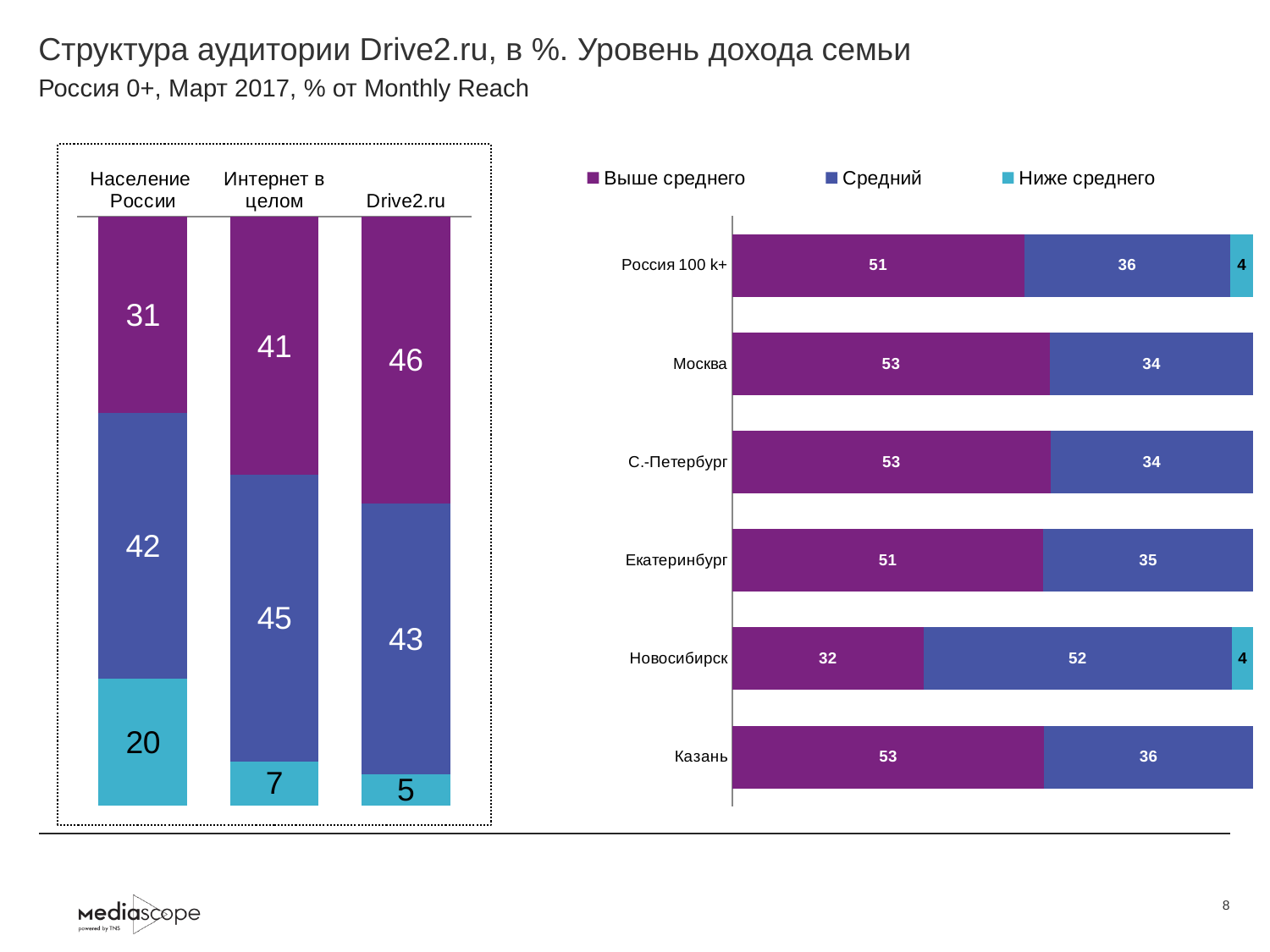
In the left chart, what is the difference between the 'Выше среднего' values for Drive2.ru and Население России? 15 How many series does the legend of the right chart list? 3 In the left chart, what is the value of the middle (Средний) segment for Интернет в целом? 45 In the left chart, what is the total of the three segments for Население России? 93 In the right chart, which city has the lowest 'Выше среднего' value? Новосибирск In the left chart, what is the value of the top (Выше среднего) segment for Drive2.ru? 46 How many cities/regions are shown in the right chart? 6 In the right chart, which is larger: the 'Средний' value for Новосибирск or for Екатеринбург? Новосибирск In the left chart, what is the value of the 'Ниже среднего' segment for Население России? 20 In the right chart, what is the 'Выше среднего' value for Новосибирск? 32 In the right chart, what is the 'Средний' value for Казань? 36 In the left chart, which of the three columns has the smallest 'Ниже среднего' segment? Drive2.ru